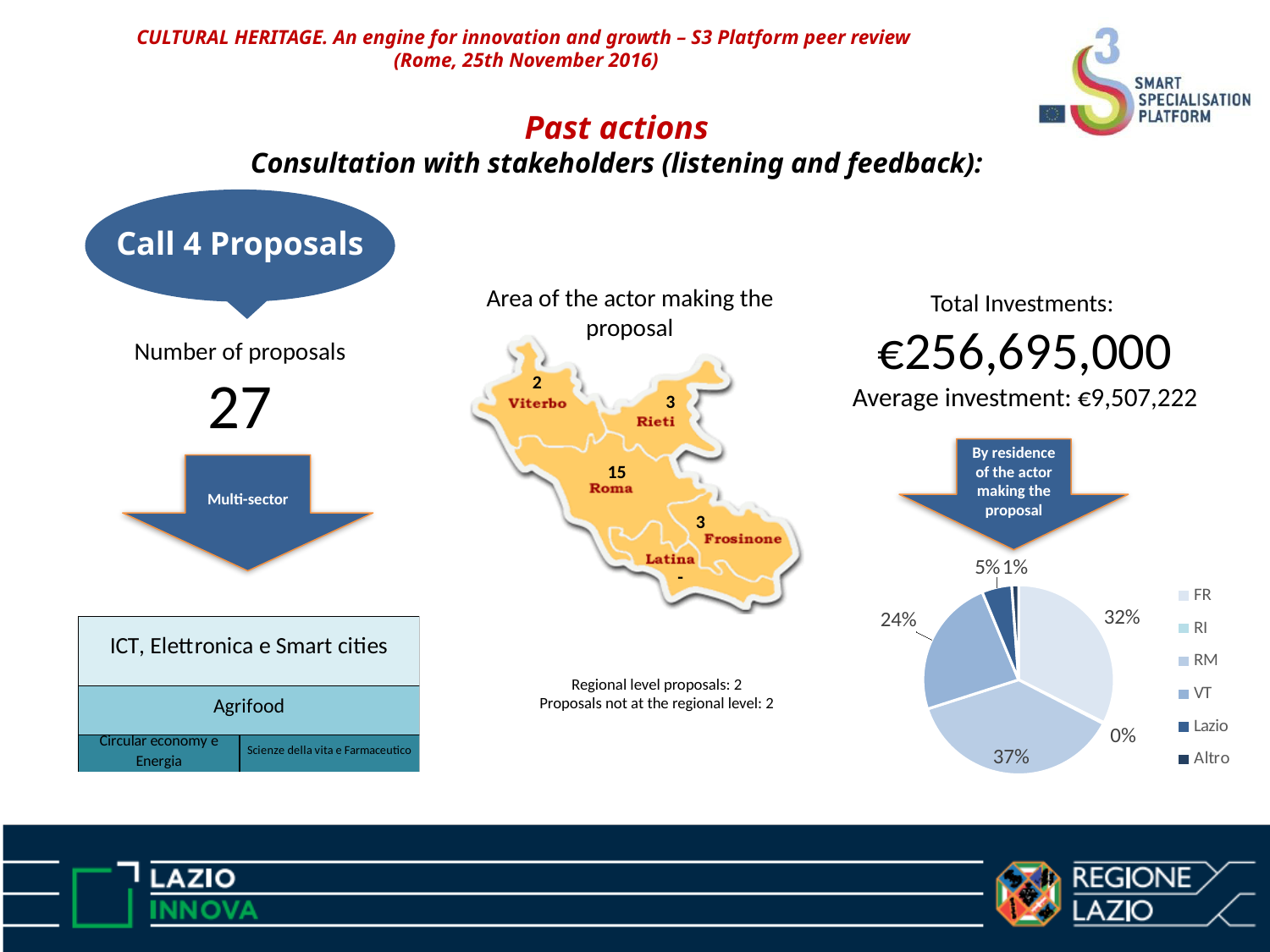
In the pie chart, what share is labelled for VT? 24% In the pie chart, what share is labelled for RM? 37% In the pie chart, what share is labelled for RI? 0% Which legend entry in the pie chart is shown in the darkest blue? Altro In the pie chart, what is the difference in percentage points between the RM and FR slices? 5 What kind of chart is shown under "By residence of the actor making the proposal"? pie chart In the pie chart, what share is labelled for Lazio? 5% In the pie chart, what share is labelled for FR? 32% In the pie chart, which slice is larger, VT or Lazio? VT Which legend entry has the largest slice in the pie chart? RM How many entries does the legend of the pie chart list? 6 Which legend entry has the smallest slice in the pie chart? RI